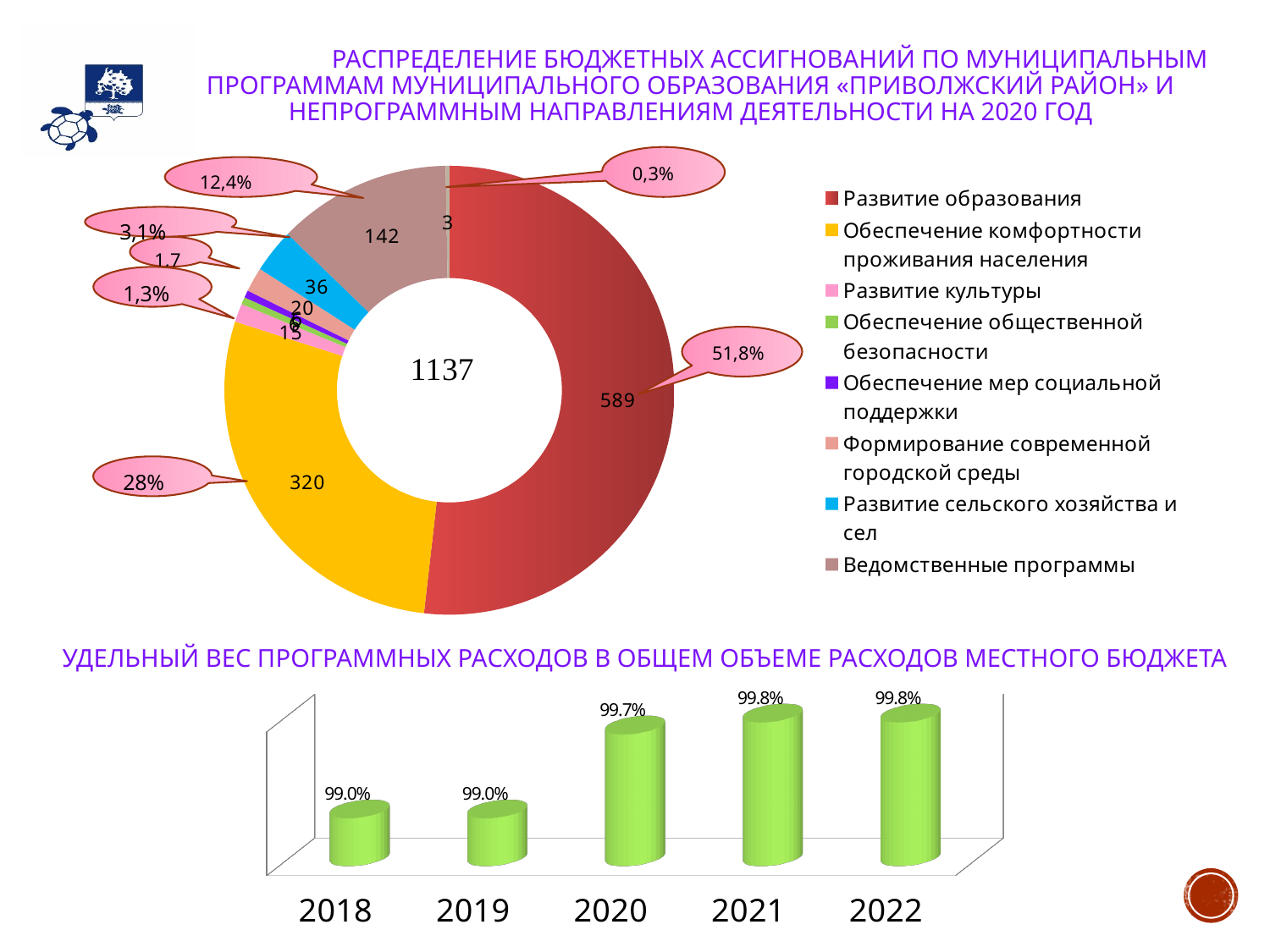
In the doughnut chart at the top, what percentage share is shown for Ведомственные программы? 12,4% What kind of chart is the chart at the bottom of the slide? Bar chart How many years are shown on the x axis of the bar chart at the bottom? 5 In the doughnut chart at the top, what value is shown for Развитие образования? 589 In the doughnut chart at the top, what percentage share is shown for Развитие образования? 51,8% In the doughnut chart at the top, what value is shown for Обеспечение комфортности проживания населения? 320 In the doughnut chart at the top, what number is shown in the centre of the ring? 1137 In the doughnut chart at the top, which category has the largest value? Развитие образования In the bar chart at the bottom, what value is shown for 2020? 99.7% In the bar chart at the bottom, do the values rise or fall from 2018 to 2022? Rise In the doughnut chart at the top, what is the difference between the values for Развитие образования and Обеспечение комфортности проживания населения? 269 How many entries does the legend of the doughnut chart at the top list? 8